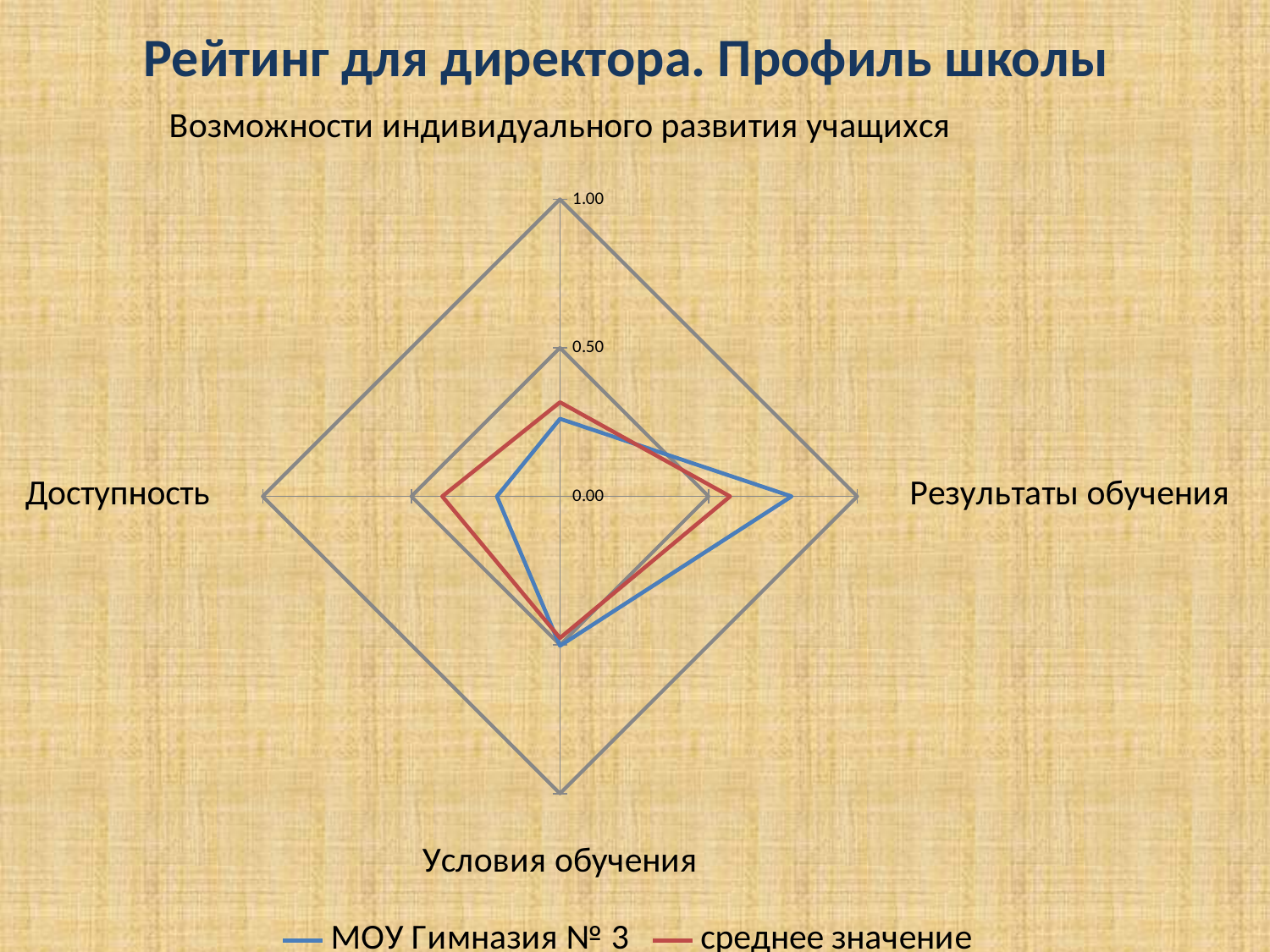
How many series does the legend list? 2 Is the value of среднее значение for Доступность greater or less than 0.50? less What kind of chart is shown on the slide? Radar chart Is the value of МОУ Гимназия № 3 for Доступность greater or less than 0.50? less Is the value of МОУ Гимназия № 3 for Результаты обучения greater or less than 0.50? greater For Доступность, which series has the larger value: МОУ Гимназия № 3 or среднее значение? среднее значение What is the title of the slide? Рейтинг для директора. Профиль школы How many axes (categories) does the radar chart have? 4 On which axis does МОУ Гимназия № 3 have its highest value? Результаты обучения For Результаты обучения, which series has the larger value: МОУ Гимназия № 3 or среднее значение? МОУ Гимназия № 3 Which series is drawn in blue? МОУ Гимназия № 3